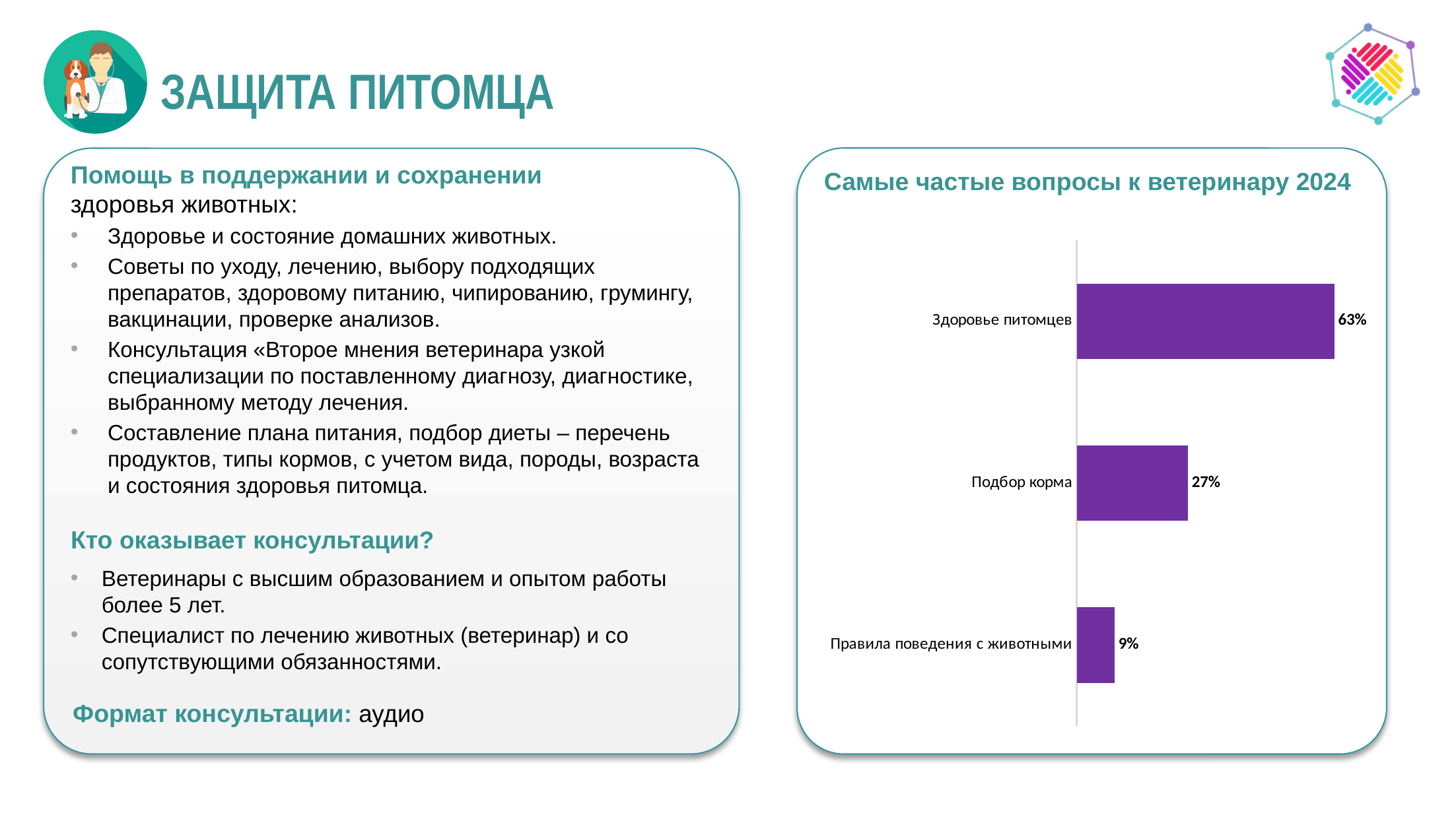
Which category has the highest value? Здоровье питомцев What is the difference between the values for Здоровье питомцев and Подбор корма? 36% What is the value for Здоровье питомцев? 63% Which category has the lowest value? Правила поведения с животными What is the difference between the values for Подбор корма and Правила поведения с животными? 18% What is the value for Правила поведения с животными? 9% What kind of chart is shown on the slide? bar chart Which is larger, the value for Подбор корма or the value for Правила поведения с животными? Подбор корма What is the value for Подбор корма? 27% What is the title of the chart? Самые частые вопросы к ветеринару 2024 What colour are the bars in the chart? purple How many categories are shown in the chart? 3